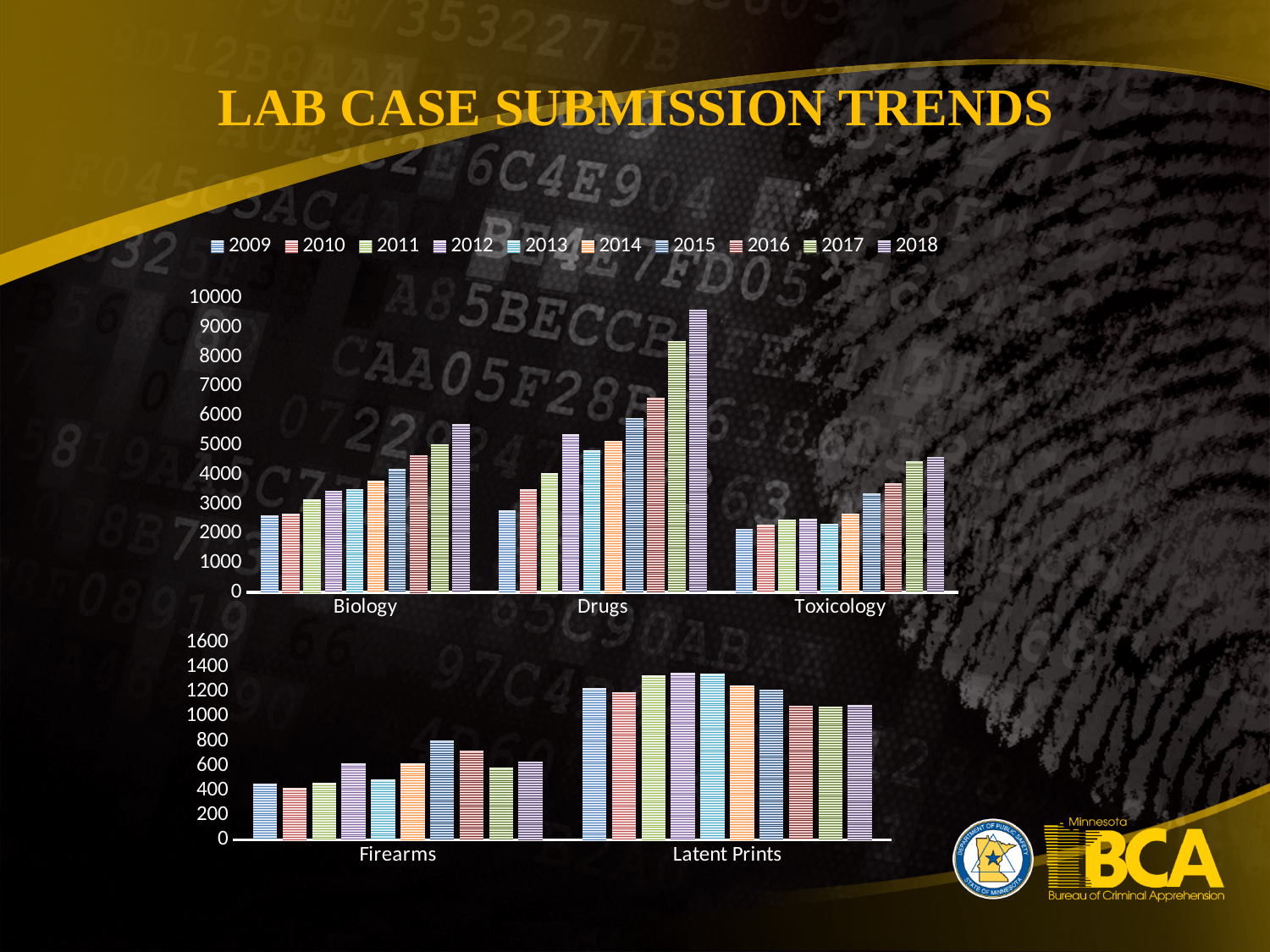
In the top chart, do the Drugs values generally rise or fall from 2009 to 2018? rise How many years does the legend list for the charts? 10 How many categories are shown on the x axis of the top chart? 3 What kind of chart is the top chart showing Biology, Drugs and Toxicology? bar chart How many categories are shown on the x axis of the bottom chart? 2 In the top chart, is the value for Drugs in 2018 greater or less than 9000? greater In the top chart, is the value for Biology in 2009 greater or less than 3000? less In the bottom chart, which year has the tallest bar for Firearms? 2015 In the top chart, which category contains the tallest bar? Drugs In the bottom chart, is the value for Firearms in 2015 greater or less than 600? greater In the bottom chart, which is larger in 2009: Firearms or Latent Prints? Latent Prints